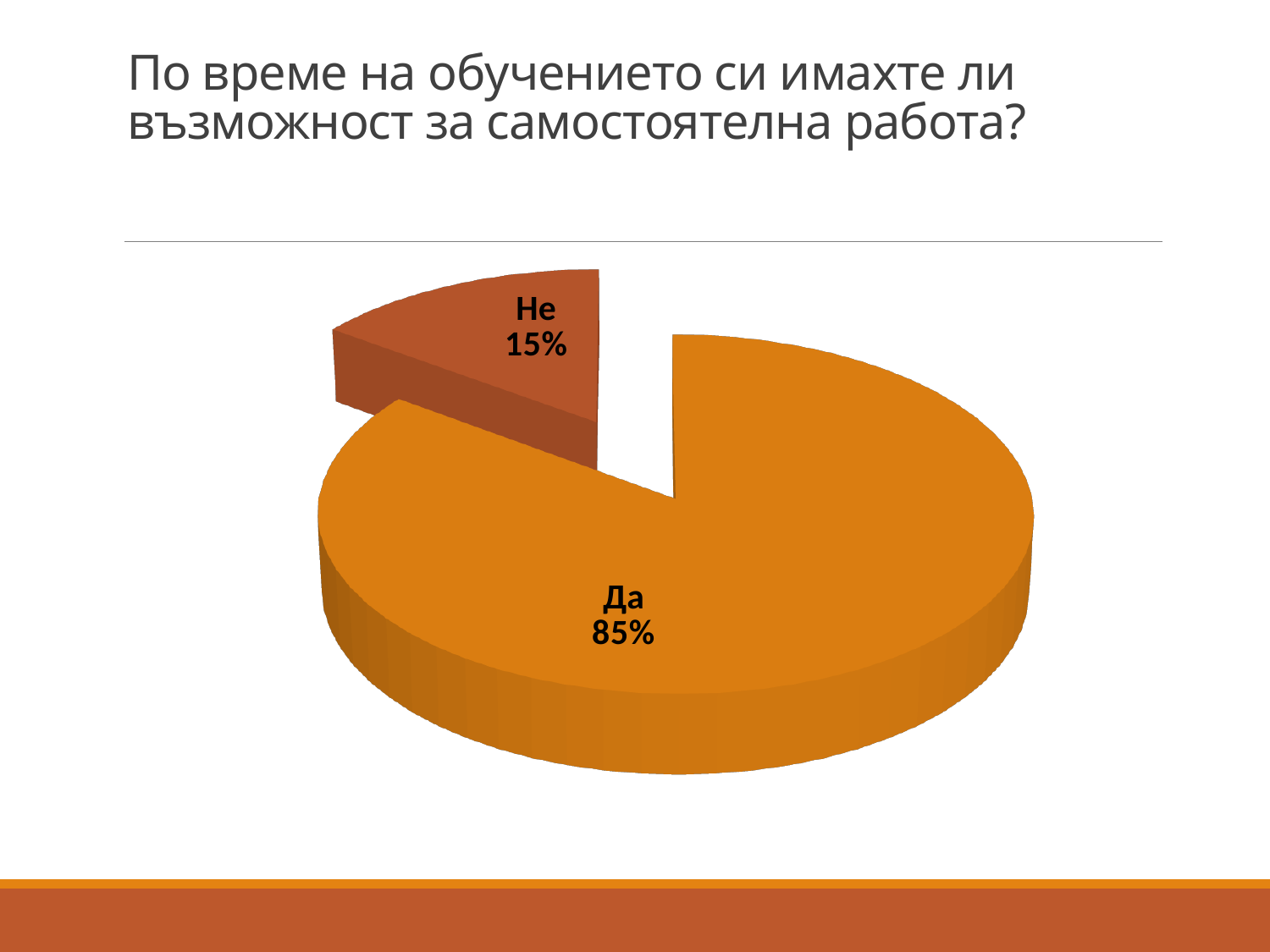
Which slice is the smallest in the pie chart? Не What kind of chart is shown on the slide? Pie chart What share of the pie does the "Не" slice represent? 15% What is the title of the slide containing the pie chart? По време на обучението си имахте ли възможност за самостоятелна работа? Is the value for "Да" greater or less than 80%? greater Which is larger, the "Да" slice or the "Не" slice? Да How many slices does the pie chart have? 2 What share of the pie does the "Да" slice represent? 85% Which slice is the largest in the pie chart? Да Is the value for "Не" greater or less than 20%? less What is the difference in percentage points between the "Да" and "Не" slices? 70 What is the total of the two slices shown in the pie chart? 100%